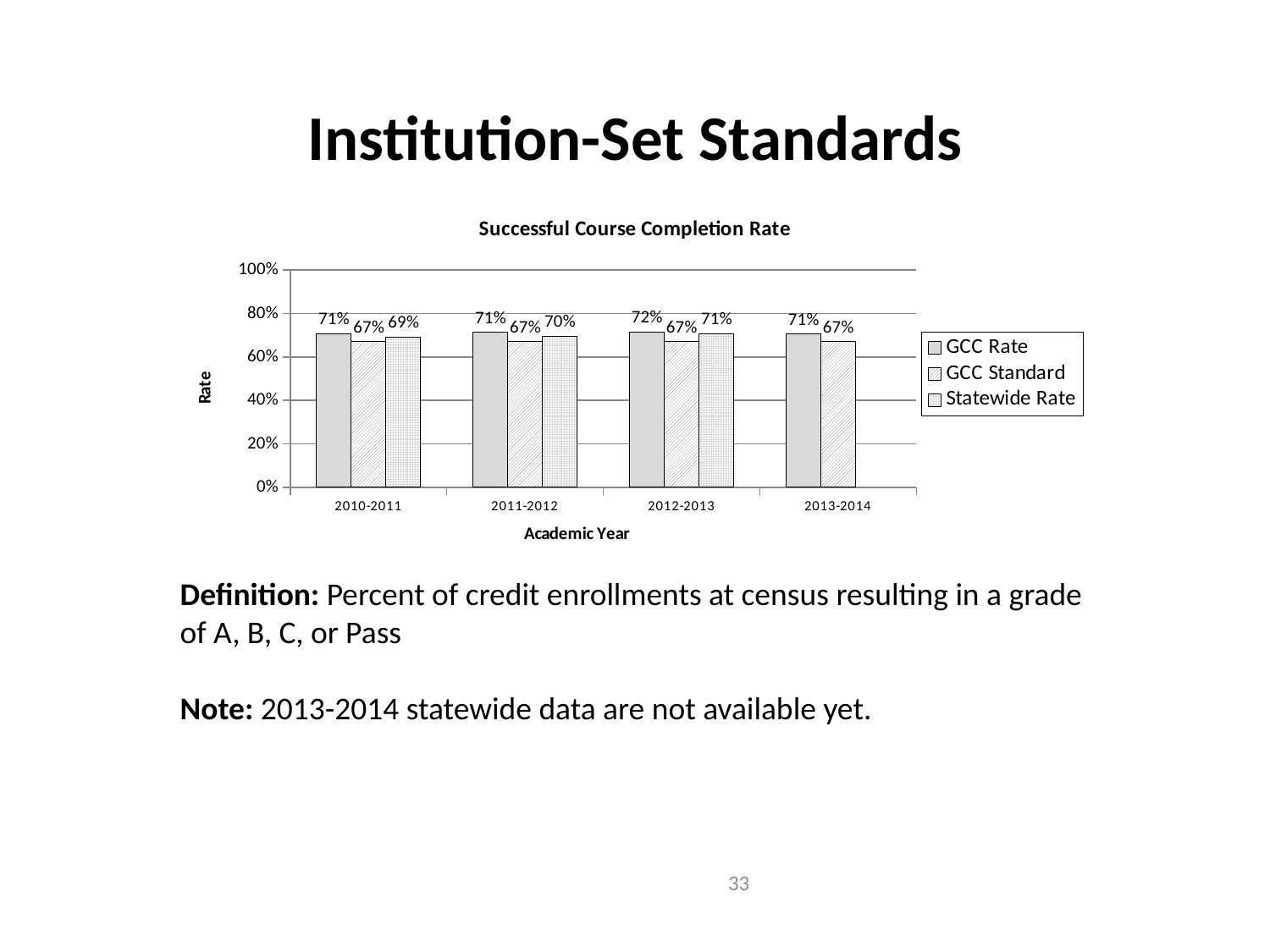
What is the GCC Standard for 2013-2014? 67% What is the difference between the GCC Rate and the GCC Standard in 2012-2013? 5% Which is larger in 2011-2012, the GCC Rate or the Statewide Rate? GCC Rate What is the Statewide Rate for 2011-2012? 70% What is the title of the chart? Successful Course Completion Rate What is the GCC Rate for 2012-2013? 72% How many series does the legend list? 3 What kind of chart is shown on the slide? Bar chart Which academic year has the highest GCC Rate? 2012-2013 What is the Statewide Rate for 2010-2011? 69% Which academic year has the lowest Statewide Rate? 2010-2011 How many academic years are shown on the x axis? 4